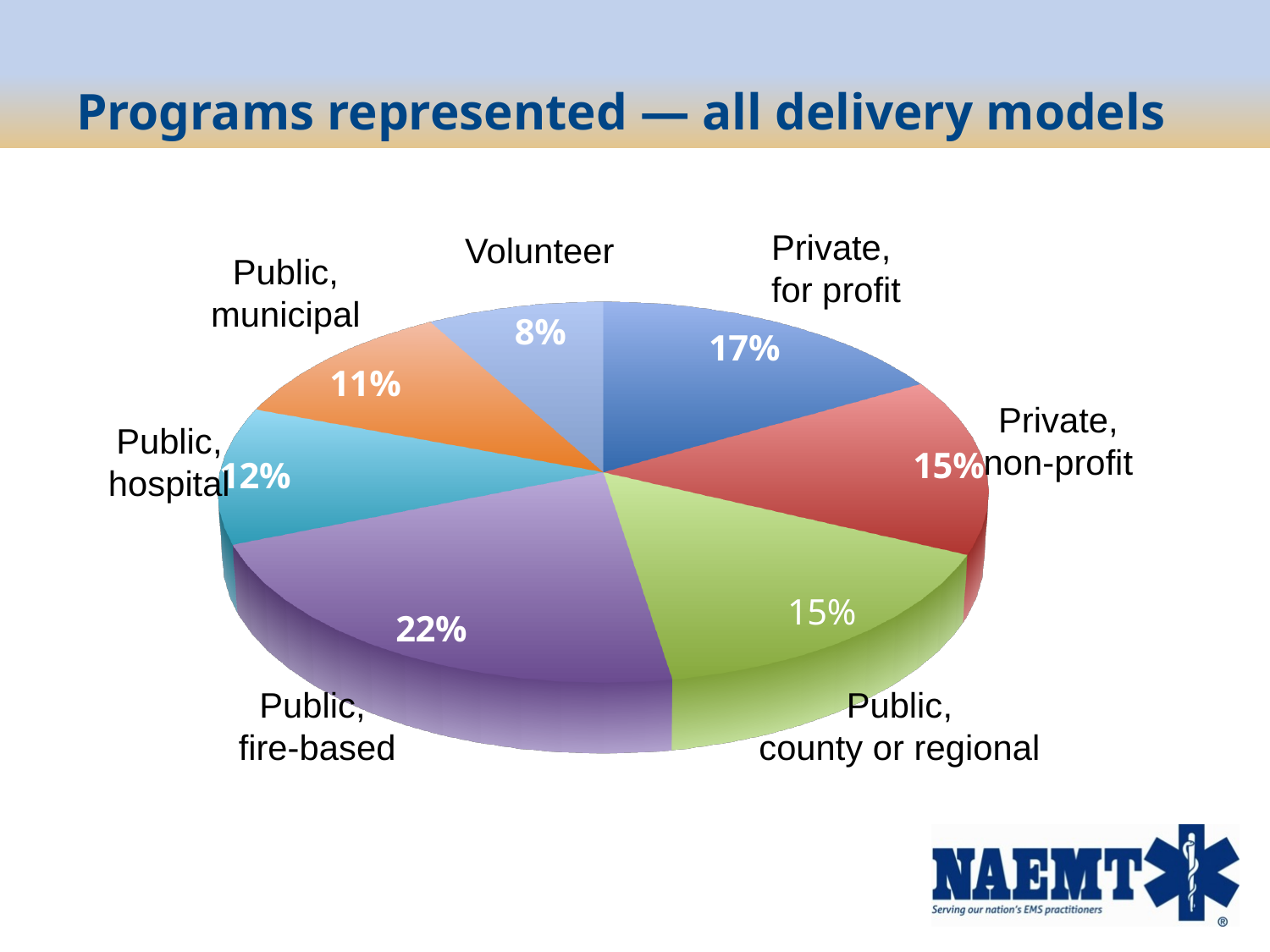
How many delivery models are shown in the pie chart? 7 What share of programs is Public, municipal? 11% Which delivery model has the largest share of programs? Public, fire-based What share of programs is Volunteer? 8% What share of programs is Public, hospital? 12% Which is larger, the share for Public, municipal or the share for Public, hospital? Public, hospital Which delivery model has the smallest share of programs? Volunteer What share of programs is Private, for profit? 17% What share of programs is Public, fire-based? 22% What is the difference in percentage points between Public, fire-based and Private, for profit? 5 What kind of chart is shown on the slide? Pie chart What is the title of the slide? Programs represented — all delivery models